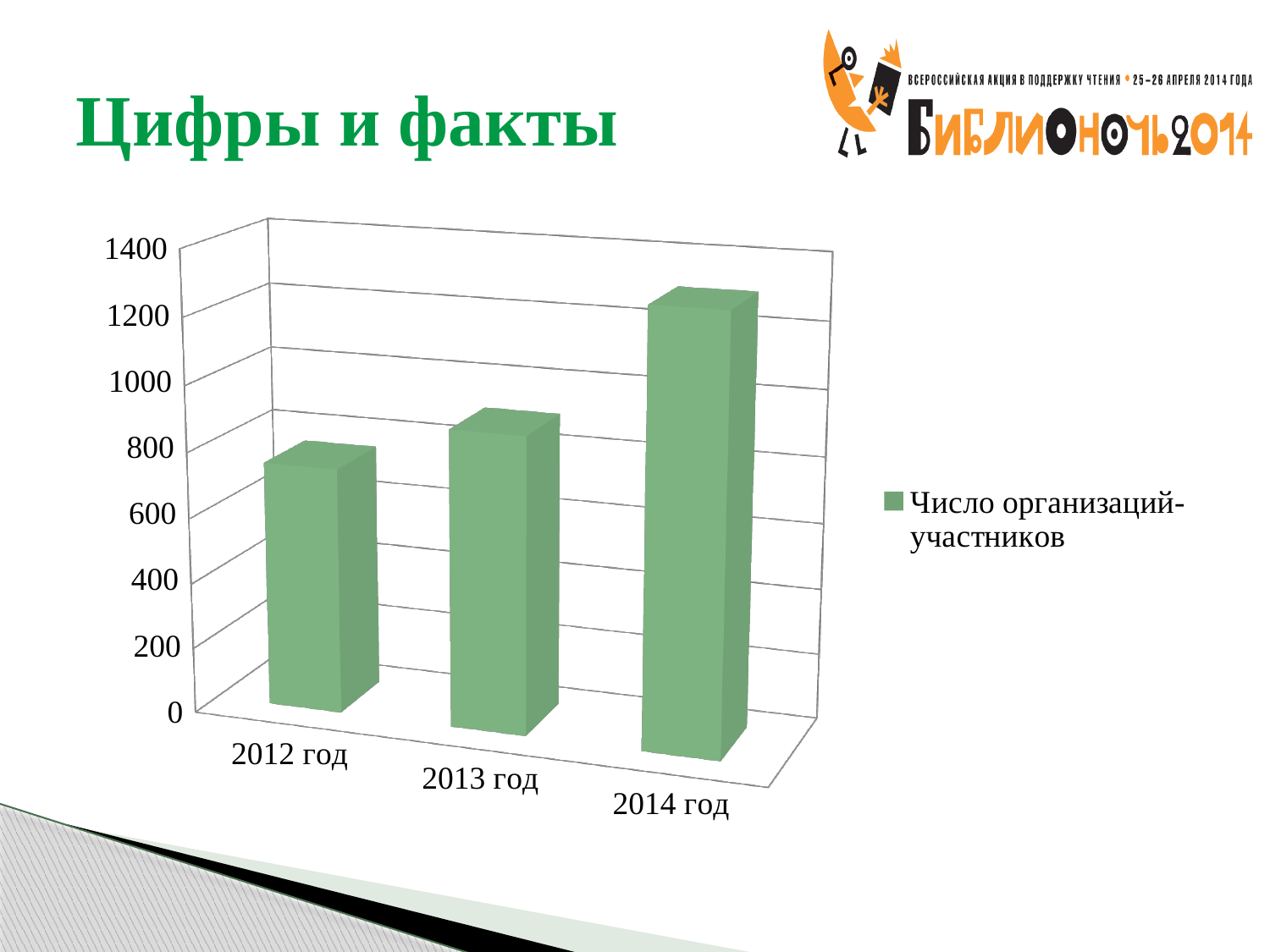
What series name is shown in the chart legend? Число организаций-участников Do the values rise or fall from 2012 год to 2014 год? rise Which year has the lowest value in the chart? 2012 год Which year has the highest value in the chart? 2014 год Which is larger, the value for 2013 год or the value for 2014 год? 2014 год How many categories (years) are shown on the x axis of the chart? 3 Is the value for 2012 год greater or less than 1000? less What kind of chart is shown on the slide? bar chart Is the value for 2014 год greater or less than 1000? greater Is the value for 2012 год greater or less than 400? greater How many series does the chart legend list? 1